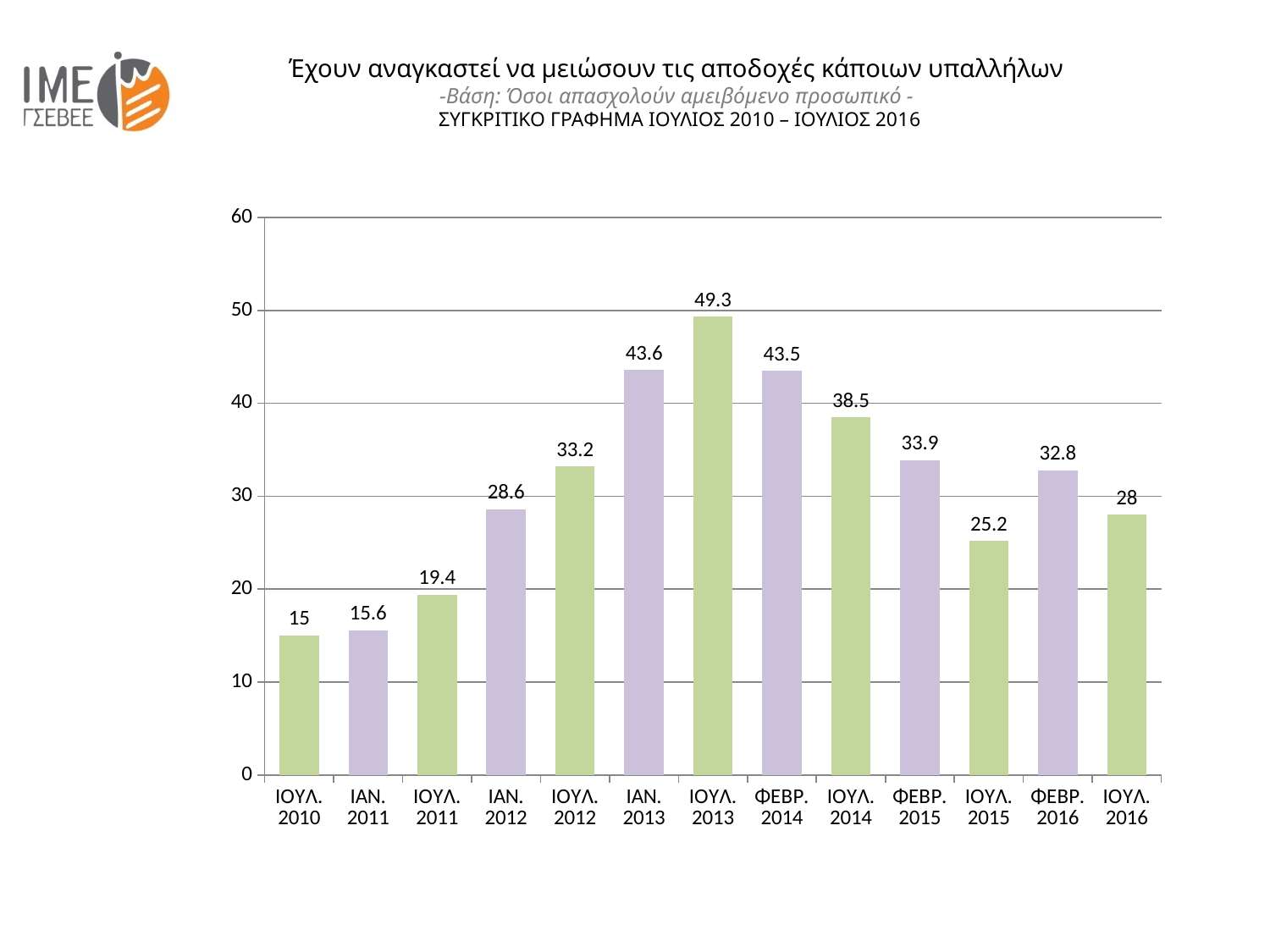
Which is larger, the value for ΙΑΝ. 2013 or the value for ΦΕΒΡ. 2014? ΙΑΝ. 2013 What is the difference between the values for ΙΑΝ. 2011 and ΙΟΥΛ. 2010? 0.6 What is the difference between the values for ΙΟΥΛ. 2013 and ΙΟΥΛ. 2016? 21.3 What kind of chart is shown on the slide? bar chart Which category has the lowest value? ΙΟΥΛ. 2010 Do the values rise or fall from ΙΟΥΛ. 2010 to ΙΟΥΛ. 2013? rise Which category has the highest value? ΙΟΥΛ. 2013 What is the value for ΙΟΥΛ. 2010? 15 How many categories are shown on the x axis? 13 Is the value for ΙΟΥΛ. 2015 greater or less than 30? less What is the value for ΦΕΒΡ. 2016? 32.8 What is the value for ΙΟΥΛ. 2013? 49.3